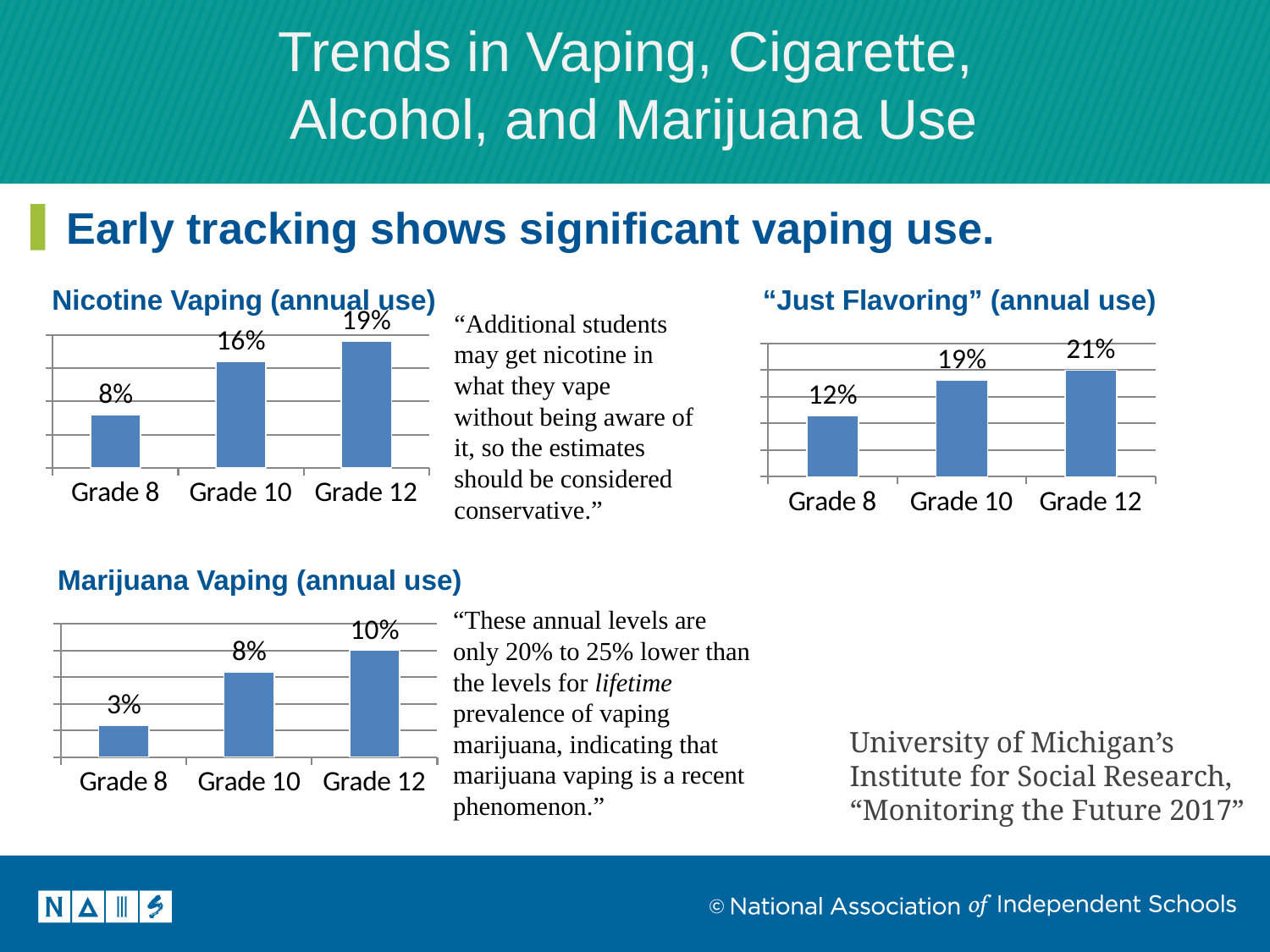
In the Marijuana Vaping (annual use) chart, what is the value for Grade 12? 10% What kind of chart is the "Just Flavoring" (annual use) chart? Bar chart In the Nicotine Vaping (annual use) chart, what is the difference between the Grade 12 and Grade 10 values? 3% Which is larger: the Grade 10 value in the Nicotine Vaping chart or the Grade 10 value in the "Just Flavoring" chart? "Just Flavoring" Grade 10 (19%) In the "Just Flavoring" (annual use) chart, what is the difference between the Grade 12 and Grade 8 values? 9% In the Marijuana Vaping (annual use) chart, which grade has the lowest value? Grade 8 In the Nicotine Vaping (annual use) chart, what is the value for Grade 10? 16% How many grade categories are shown in the Marijuana Vaping (annual use) chart? 3 In the "Just Flavoring" (annual use) chart, what is the value for Grade 8? 12% In the Nicotine Vaping (annual use) chart, which grade has the highest value? Grade 12 In the Marijuana Vaping (annual use) chart, do the values rise or fall from Grade 8 to Grade 12? Rise How many charts are shown on the slide? 3